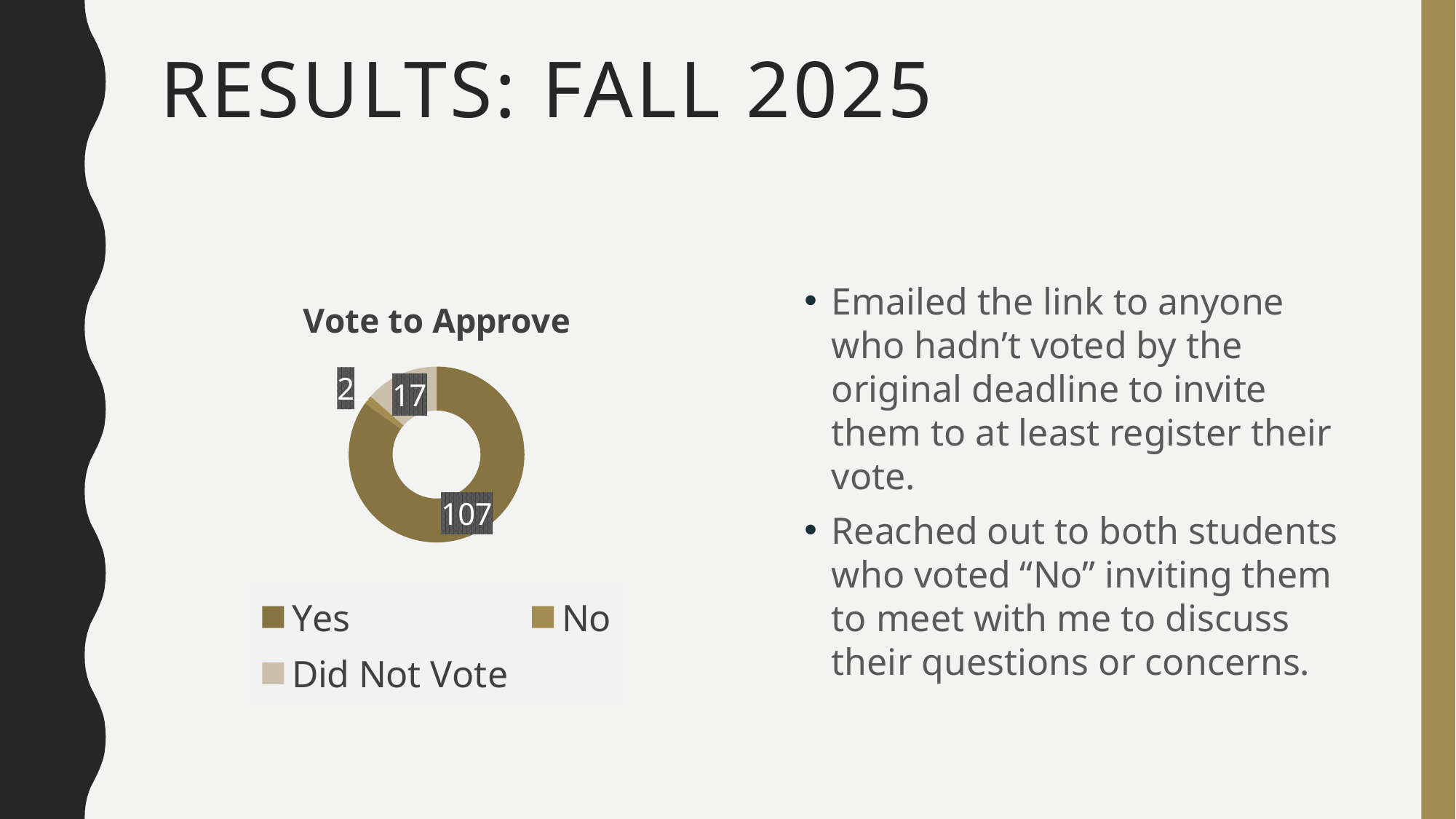
Which category has the smallest value in the chart? No What is the title of the chart? Vote to Approve What is the difference between the Yes votes and the Did Not Vote count? 90 How many people voted No according to the chart? 2 What is the difference between the Did Not Vote count and the No votes? 15 What kind of chart is shown on the slide? Doughnut chart How many categories does the chart show? 3 How many people are in the Did Not Vote category? 17 Which is larger, the number of No votes or the number who Did Not Vote? Did Not Vote Which category has the largest value in the chart? Yes What is the total of all three categories in the chart? 126 How many people voted Yes according to the chart? 107